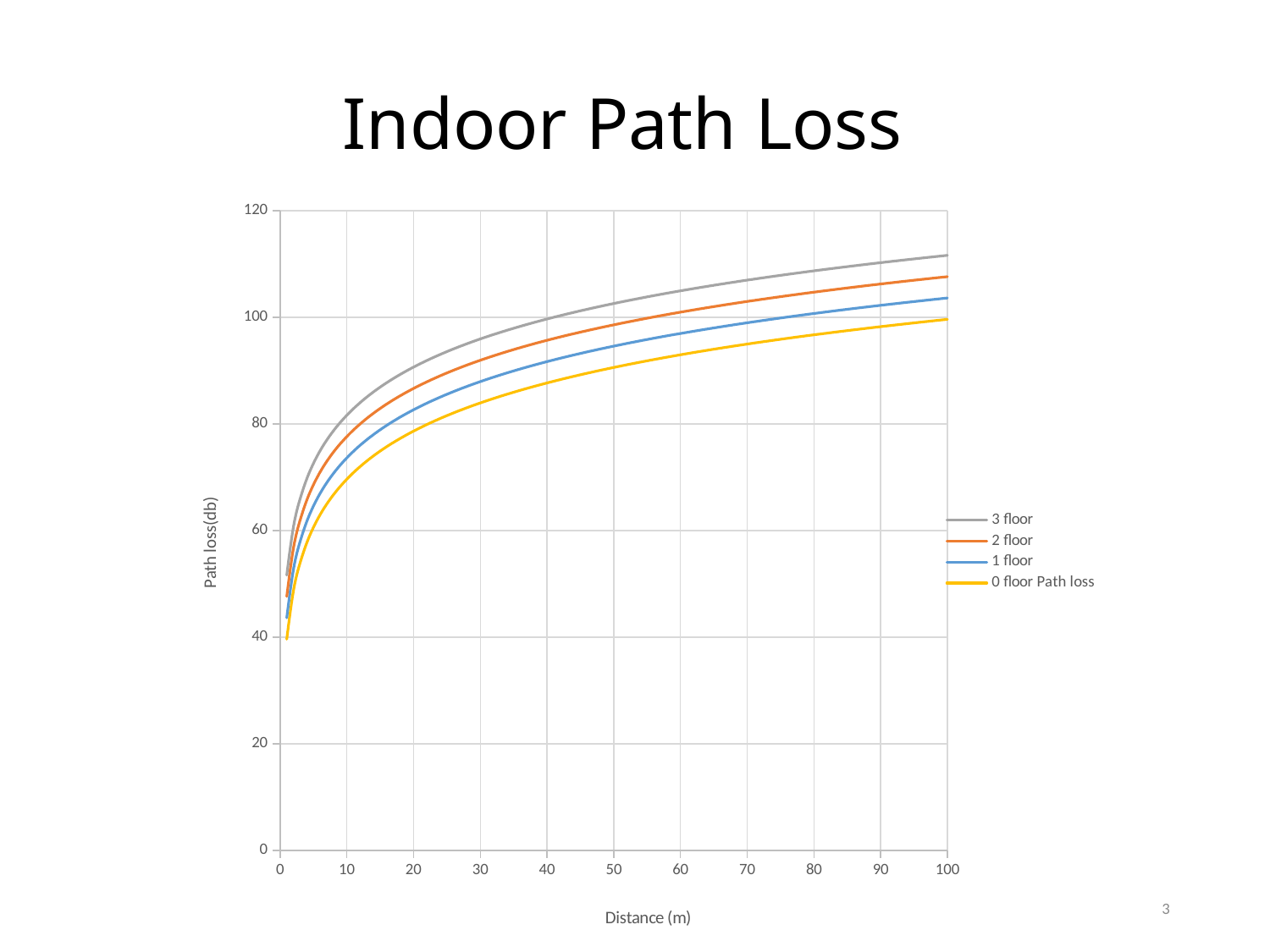
What kind of chart is shown on the slide? line chart Which series has the lowest path loss across the distance range? 0 floor Path loss Is the path loss for the 2 floor series at 20 m greater or less than 80? greater Is the path loss for the 3 floor series at 100 m greater or less than 100? greater What is the label of the x axis? Distance (m) What is the title of the chart? Indoor Path Loss Is the path loss for the 1 floor series at 50 m greater or less than 100? less How many series does the legend list? 4 Does the path loss rise or fall as distance increases? rise Which series has the highest path loss across the distance range? 3 floor At a distance of 50 m, which series has the larger path loss, 3 floor or 0 floor Path loss? 3 floor